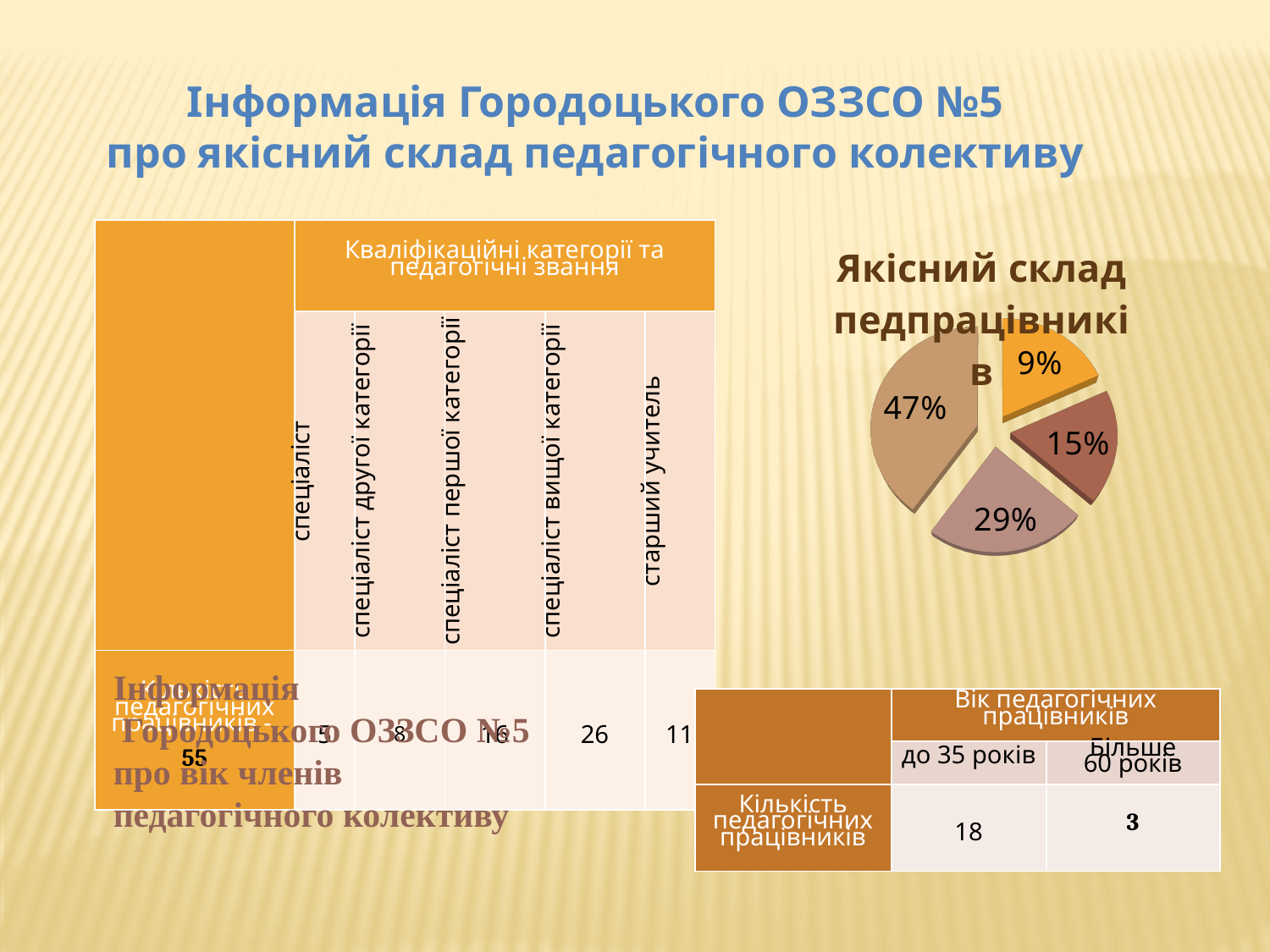
What is the share of the largest slice in the pie chart? 47% What share does the dark brown slice on the right of the pie chart represent? 15% How many slices does the pie chart have? 4 What is the title of the pie chart? Якісний склад педпрацівників What kind of chart is shown on the slide? pie chart Which slice is larger, the 29% slice or the 15% slice? the 29% slice Do the four slices of the pie chart add up to 100%? yes Is the share of the largest slice greater or less than 50%? less What is the share of the smallest slice in the pie chart? 9% What is the difference in percentage points between the largest slice (47%) and the 29% slice? 18 What share does the orange slice at the top of the pie chart represent? 9% What is the difference in percentage points between the 15% slice and the 9% slice? 6